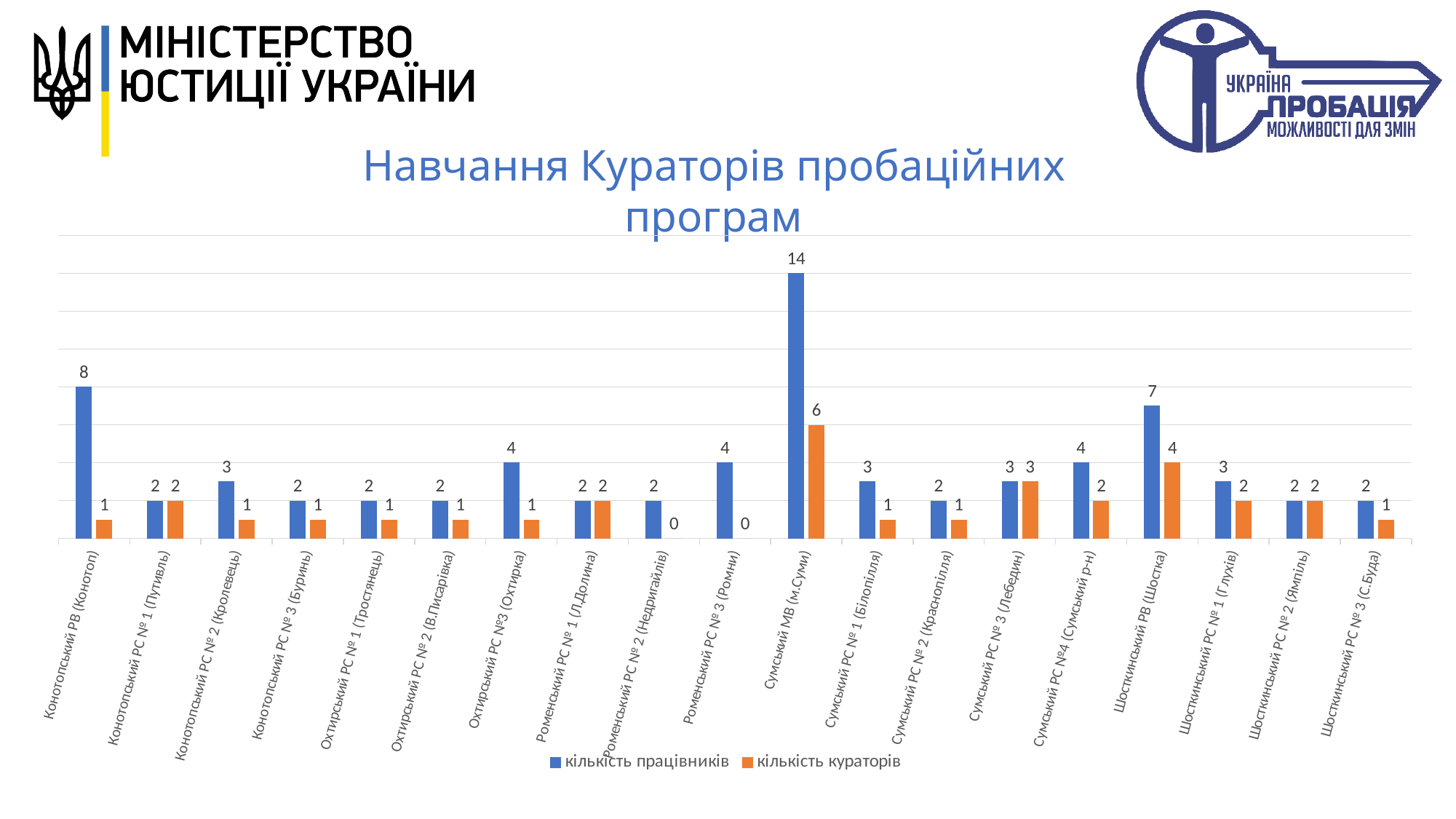
What is the title of the chart? Навчання Кураторів пробаційних програм What is the value of кількість кураторів for Шосткинський РВ (Шостка)? 4 How many series does the legend list? 2 What is the difference in кількість працівників between Сумський МВ (м.Суми) and Шосткинський РВ (Шостка)? 7 What is the difference between кількість працівників and кількість кураторів for Конотопський РВ (Конотоп)? 7 Which category has the highest value of кількість працівників? Сумський МВ (м.Суми) What is the value of кількість кураторів for Роменський РС № 3 (Ромни)? 0 Which category has the highest value of кількість кураторів? Сумський МВ (м.Суми) What type of chart is shown on the slide? bar chart Which is larger for Сумський РС №4 (Сумський р-н): кількість працівників or кількість кураторів? кількість працівників What is the value of кількість працівників for Сумський МВ (м.Суми)? 14 How many categories are shown on the x axis? 19